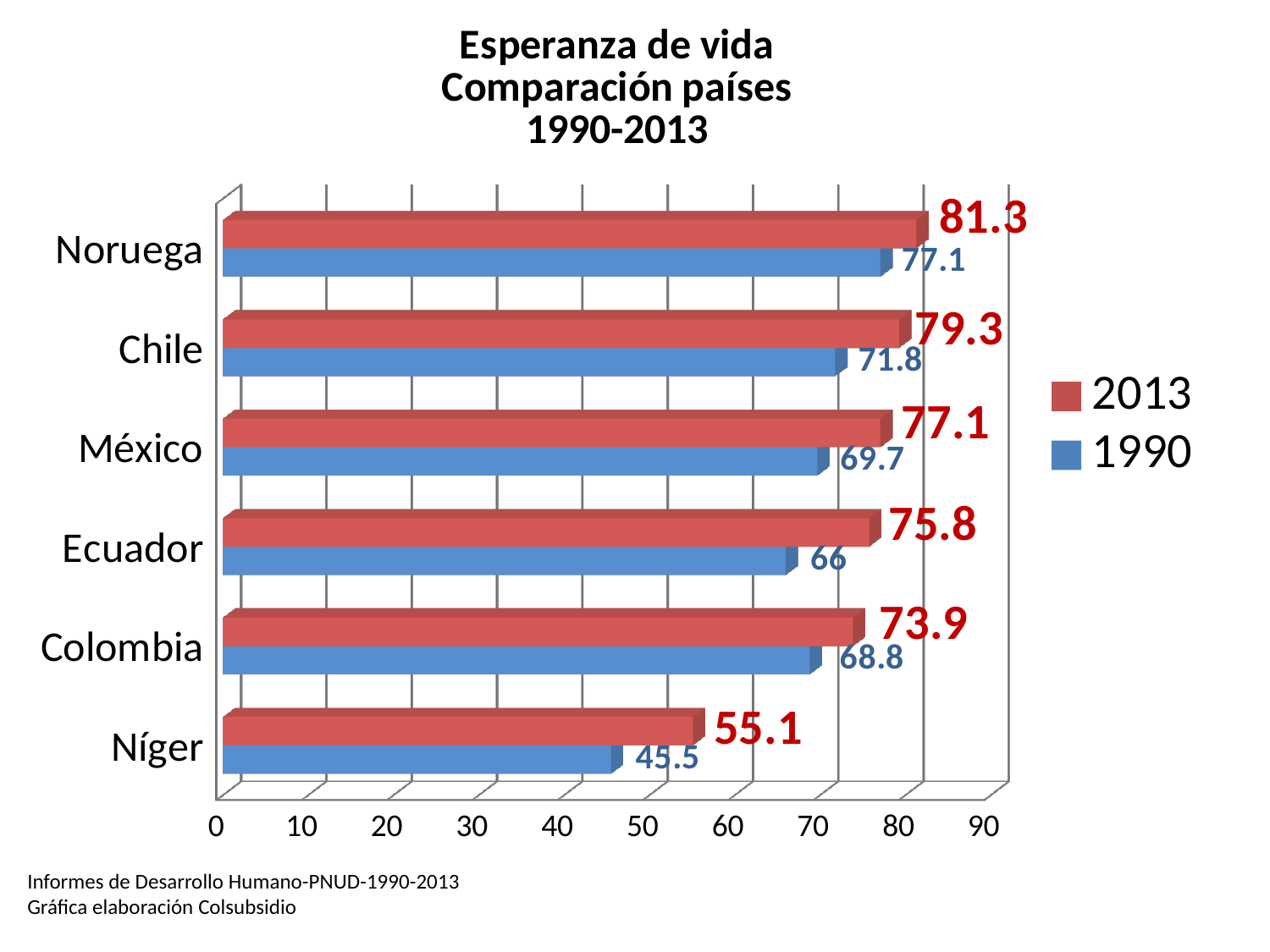
What is the 2013 life expectancy value for Noruega? 81.3 What is the difference between the 2013 values for Chile and México? 2.2 Which country has the lowest 2013 value? Níger What is the difference between the 2013 and 1990 values for Níger? 9.6 How many countries are shown on the chart? 6 What is the 1990 life expectancy value for Ecuador? 66 Which is larger: the 1990 value for Chile or the 1990 value for México? Chile What is the 1990 value for Colombia? 68.8 How many series does the legend list? 2 What kind of chart is shown on the slide? Bar chart Which colour represents the 1990 series? Blue Which country has the highest 1990 value? Noruega